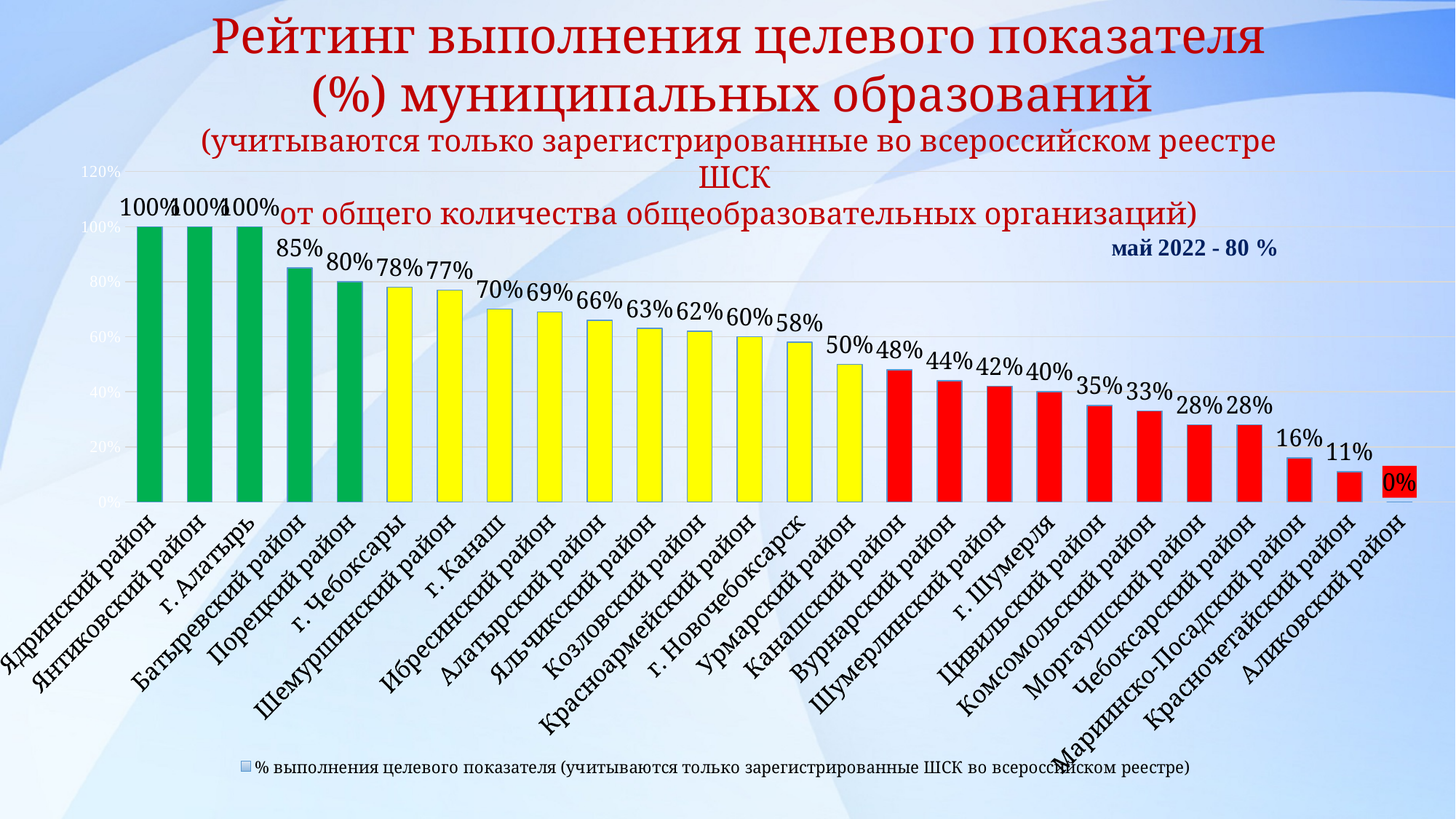
Which is larger, the value for г. Канаш or the value for г. Шумерля? г. Канаш How many categories are shown on the x axis? 26 Is the value for Цивильский район greater or less than 40%? less What is the difference between the values for Порецкий район and Канашский район? 32% What kind of chart is shown on the slide? bar chart What is the value for Красночетайский район? 11% How many series does the legend list? 1 What is the value for г. Новочебоксарск? 58% Do the values rise or fall from left to right along the x axis? fall What colour are the bars for the three categories with 100%? green Which category has the lowest value? Аликовский район What is the value for Батыревский район? 85%